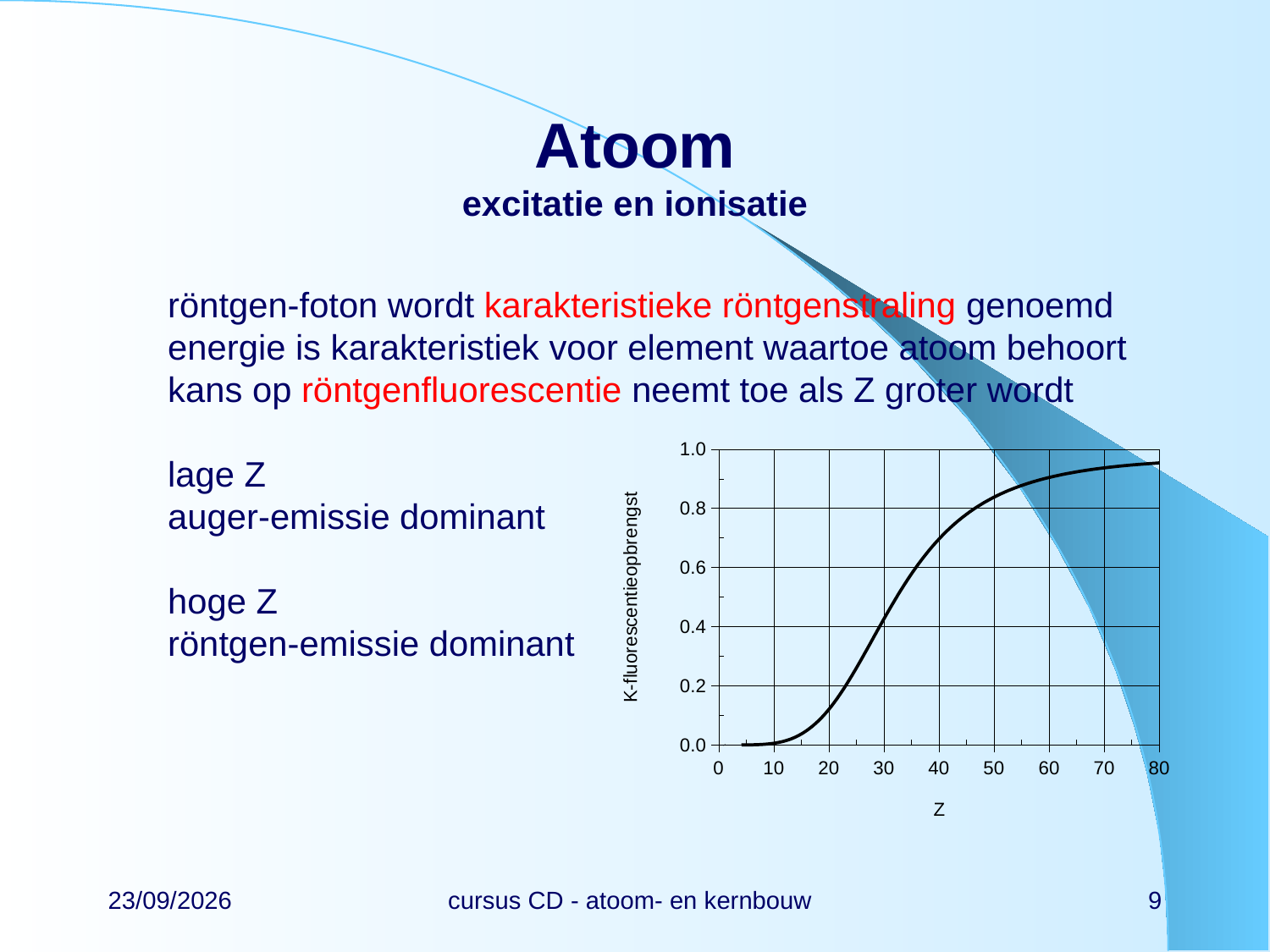
Is the value of K-fluorescentieopbrengst at Z = 60 greater or less than 0.8? greater Is the value of K-fluorescentieopbrengst at Z = 70 greater or less than 0.8? greater What kind of chart is shown on the slide? line chart Is the value of K-fluorescentieopbrengst at Z = 20 greater or less than 0.2? less What is the highest value shown on the y axis of the chart? 1.0 What is the label of the y axis of the chart? K-fluorescentieopbrengst Which is larger, the K-fluorescentieopbrengst at Z = 20 or at Z = 50? Z = 50 Does the K-fluorescentieopbrengst rise or fall as Z increases? rise At which end of the Z axis does the curve reach its highest value? Z = 80 What is the label of the x axis of the chart? Z